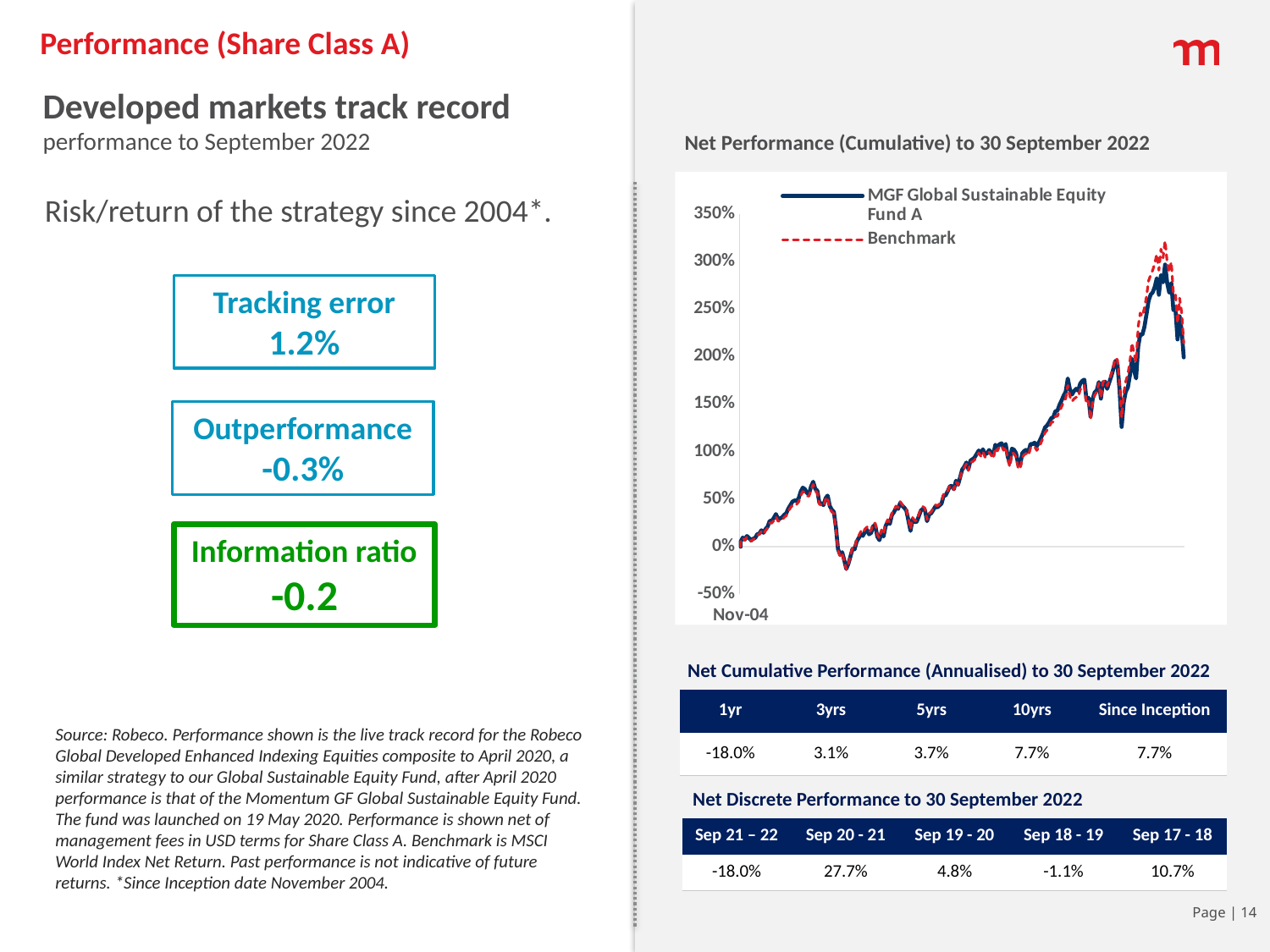
What is the lowest value labelled on the y axis of the Net Performance (Cumulative) chart? -50% Over the whole period shown in the Net Performance (Cumulative) chart, do the lines generally rise or fall? Rise In the Net Performance (Cumulative) chart, which series is drawn as a red dashed line? Benchmark What are the two series named in the legend of the Net Performance (Cumulative) chart? MGF Global Sustainable Equity Fund A and Benchmark In the Net Performance (Cumulative) chart, is the final value of the MGF Global Sustainable Equity Fund A line greater or less than 150%? greater How many series does the legend of the Net Performance (Cumulative) chart list? 2 In the Net Performance (Cumulative) chart, is the highest point reached by the Benchmark line greater or less than 250%? greater In the Net Performance (Cumulative) chart, which series reaches the higher peak, the Benchmark or the MGF Global Sustainable Equity Fund A? Benchmark In the Net Performance (Cumulative) chart, is the lowest point of the MGF Global Sustainable Equity Fund A line greater or less than 0%? less In the Net Performance (Cumulative) chart, what is the value of both series at the start (Nov-04)? 0% What kind of chart is shown under 'Net Performance (Cumulative) to 30 September 2022'? Line chart